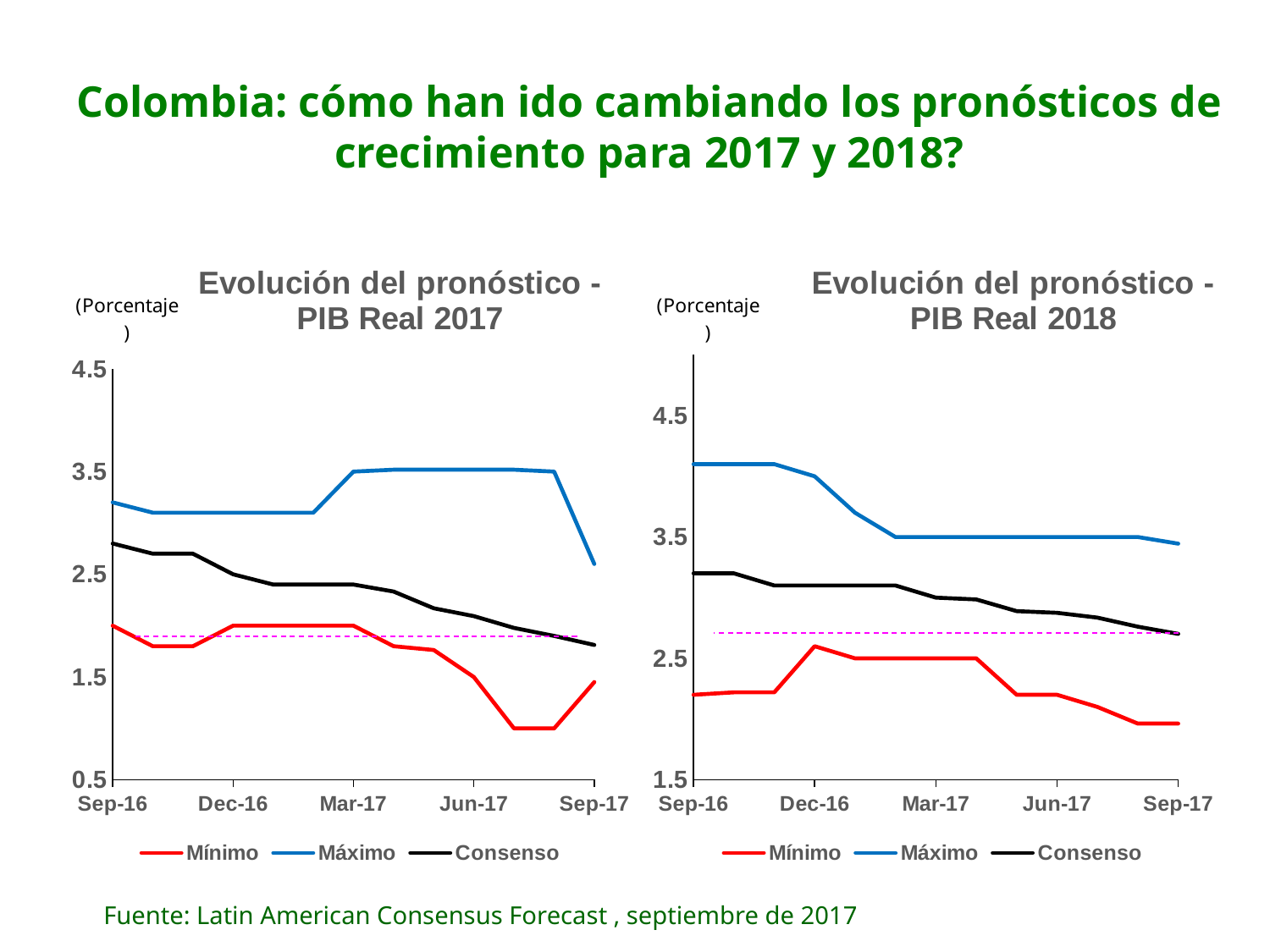
How many series does the legend of the 'Evolución del pronóstico - PIB Real 2018' chart list? 3 In the 'Evolución del pronóstico - PIB Real 2017' chart, is the Máximo value at Sep-16 greater or less than 2.5? greater What colour is the Consenso line in the charts? black In the 'Evolución del pronóstico - PIB Real 2018' chart, is the Consenso value at Sep-17 greater or less than 3.5? less In the 'Evolución del pronóstico - PIB Real 2018' chart, does the Consenso line rise or fall from Sep-16 to Sep-17? fall In the 'Evolución del pronóstico - PIB Real 2018' chart, which series has the lowest values throughout the period? Mínimo In the 'Evolución del pronóstico - PIB Real 2018' chart, is the Mínimo value at Sep-17 greater or less than 2.5? less What type of chart is the 'Evolución del pronóstico - PIB Real 2017' chart? line chart In the 'Evolución del pronóstico - PIB Real 2017' chart, which series has the highest values throughout the period? Máximo In the 'Evolución del pronóstico - PIB Real 2017' chart, which is larger at Sep-17: the Máximo value or the Consenso value? Máximo In the 'Evolución del pronóstico - PIB Real 2017' chart, does the Consenso line rise or fall from Sep-16 to Sep-17? fall